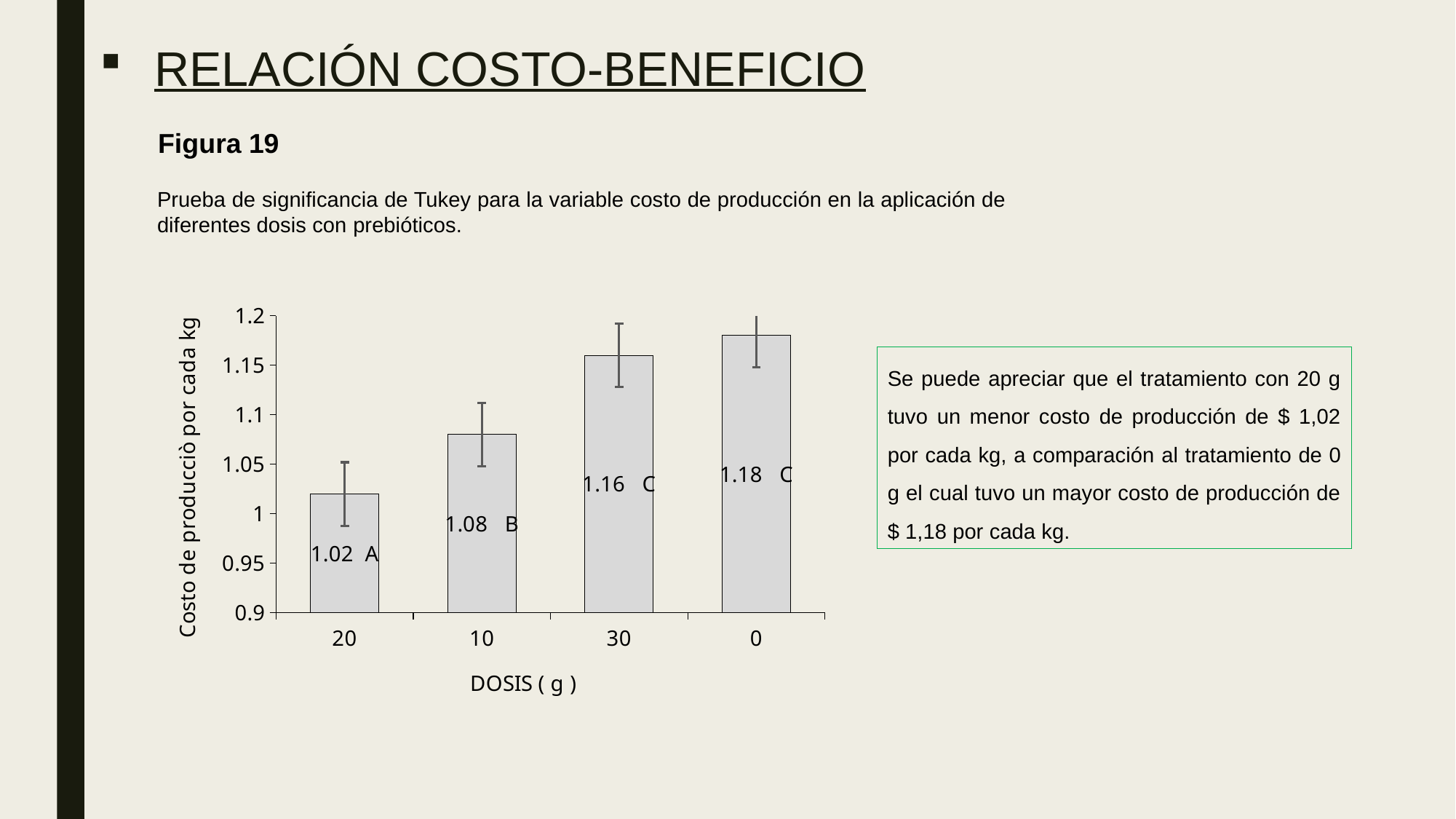
What is the production cost per kg for the 10 g dose? 1.08 Which dose has the lowest production cost per kg? 20 What is the difference in production cost per kg between the 0 g dose and the 20 g dose? 0.16 What is the label of the x axis? DOSIS ( g ) What kind of chart is shown on the slide? bar chart What is the production cost per kg for the 30 g dose? 1.16 Is the value for the 10 g dose greater or less than 1.1? less Which has a higher production cost per kg, the 10 g dose or the 30 g dose? 30 How many dose categories are shown on the x axis? 4 What is the production cost per kg for the 0 g dose? 1.18 What is the production cost per kg for the 20 g dose? 1.02 Which dose has the highest production cost per kg? 0